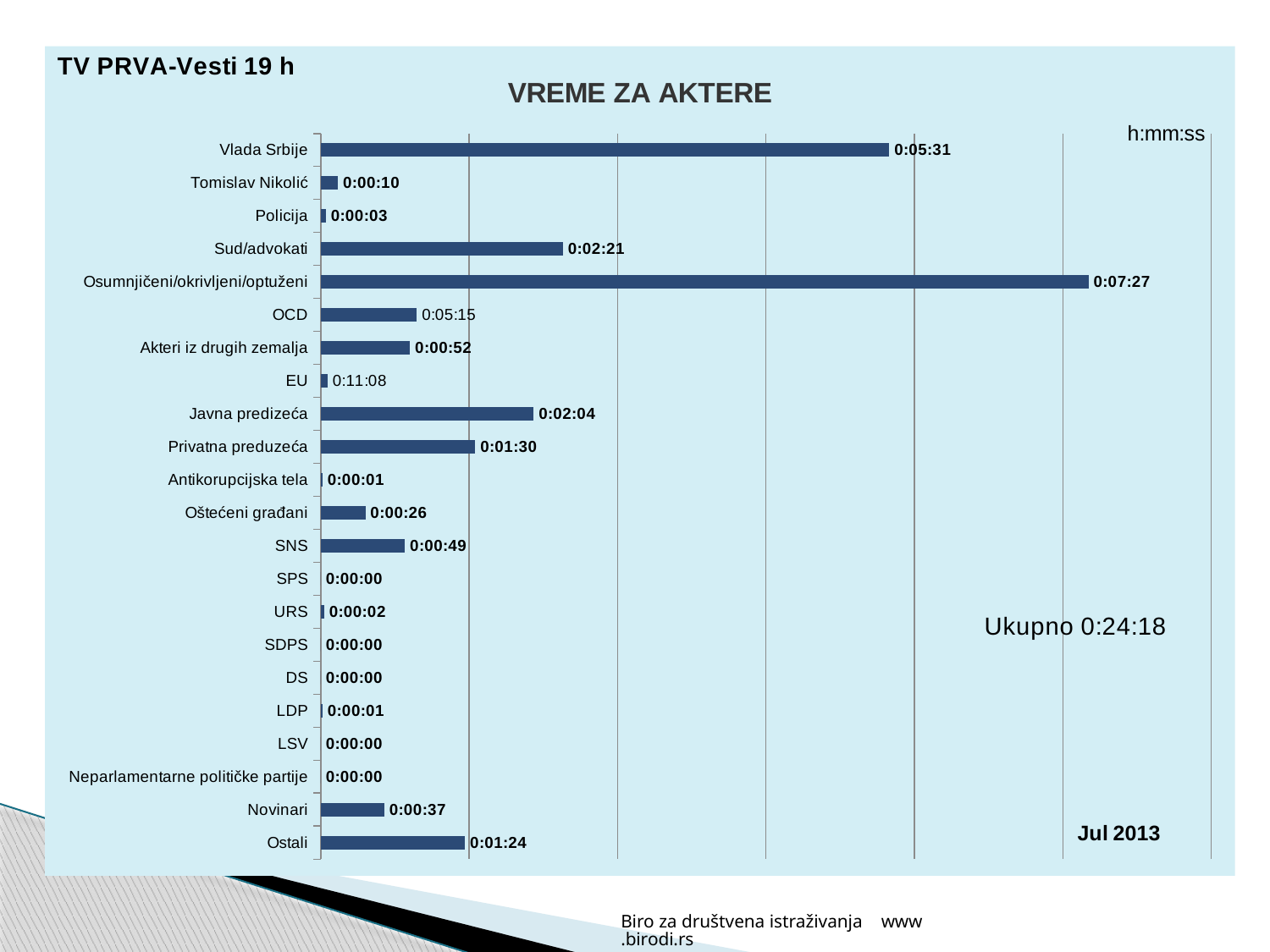
What is the value for SNS? 0:00:49 What is the difference between the values for Javna predizeća and Privatna preduzeća? 0:00:34 What kind of chart is shown on the slide? Bar chart What is the value for Novinari? 0:00:37 What is the difference between the values for Vlada Srbije and Sud/advokati? 0:03:10 What total (Ukupno) is printed on the chart? 0:24:18 What is the value for Sud/advokati? 0:02:21 How many categories are shown in the chart? 22 What is the value for Osumnjičeni/okrivljeni/optuženi? 0:07:27 What is the value for Vlada Srbije? 0:05:31 Which is larger, the value for Akteri iz drugih zemalja or the value for Oštećeni građani? Akteri iz drugih zemalja Which category has the longest bar in the chart? Osumnjičeni/okrivljeni/optuženi